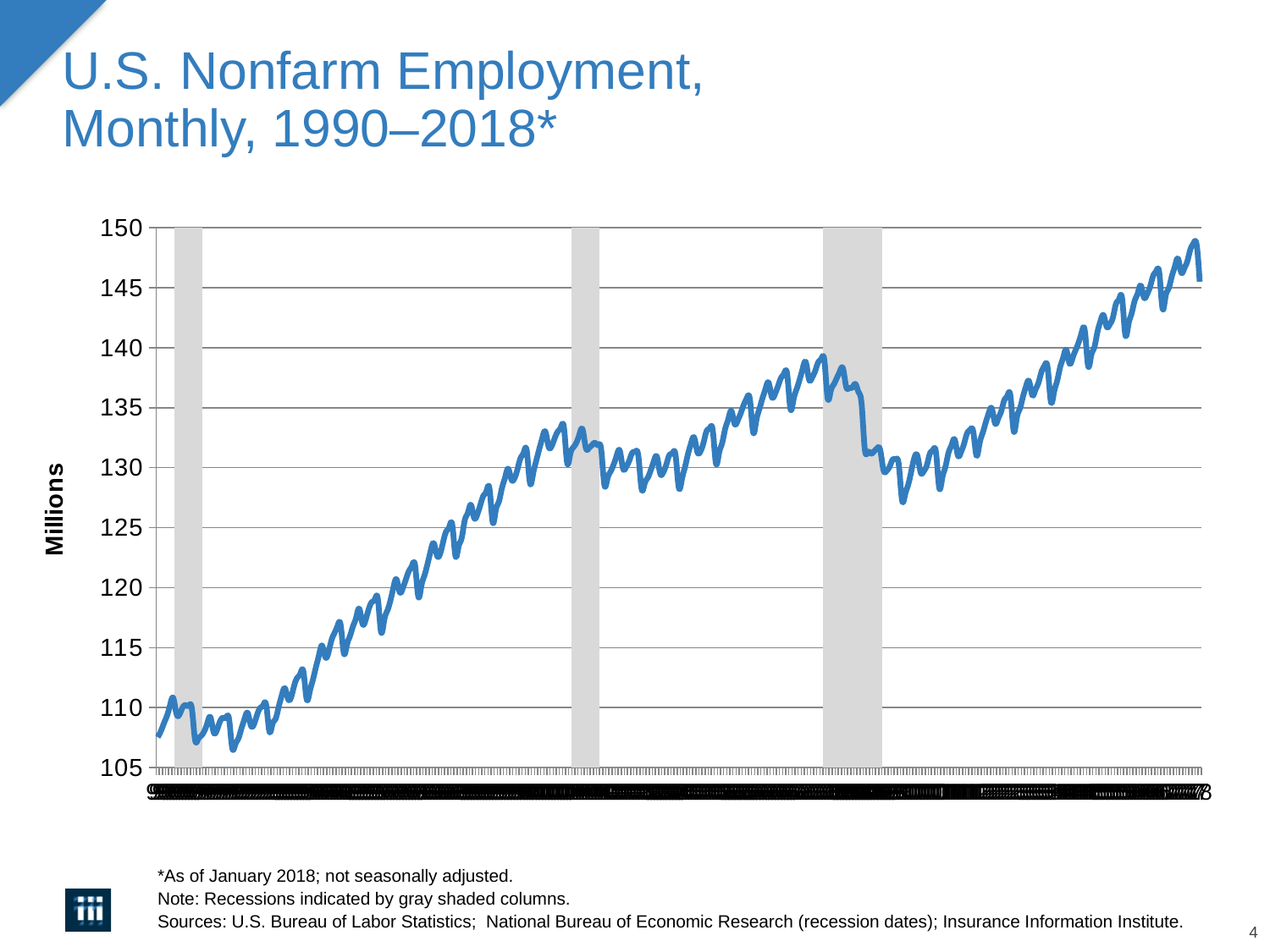
Is the value at the end of the series (rightmost point) greater or less than 140? greater Overall, does U.S. nonfarm employment rise or fall from 1990 to 2018 in the chart? Rise Is the lowest value of the series found near the beginning or near the end of the period? Near the beginning Is the peak value of the series greater or less than 145? greater What kind of chart is shown on the slide? Line chart What is the label on the vertical axis? Millions Is the highest value of the series found near the beginning or near the end of the period? Near the end Which is larger: the value at the end of the series or the value at the start of the series? The value at the end of the series Is the value at the right edge of the third gray shaded column greater or less than 135? less How many gray shaded recession columns are shown on the chart? 3